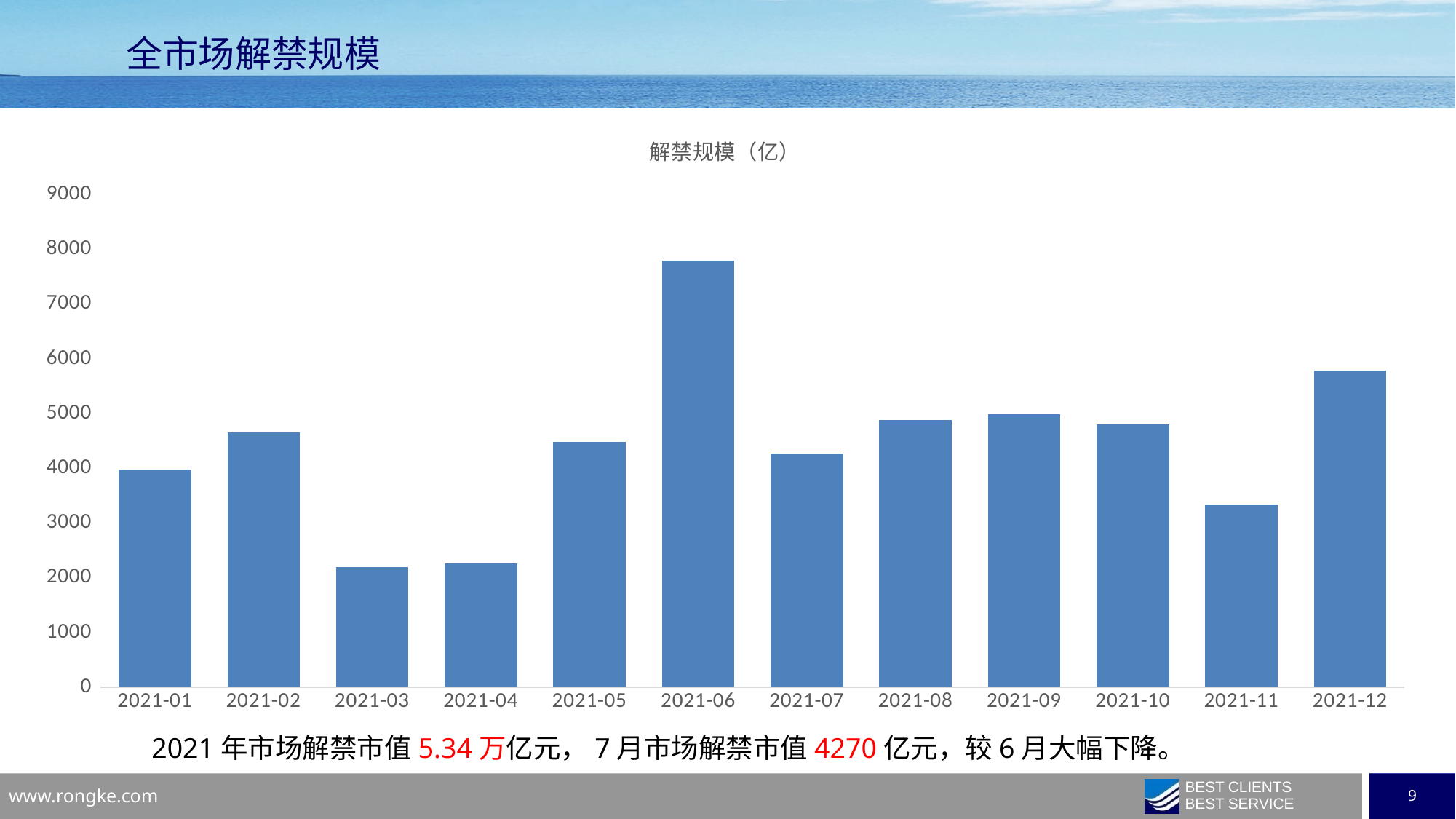
What is the title of the chart? 解禁规模（亿） What kind of chart is shown on the slide? bar chart Which is larger, the value for 2021-02 or the value for 2021-11? 2021-02 Which is larger, the value for 2021-06 or the value for 2021-12? 2021-06 Is the value for 2021-11 greater or less than 4000? less Which month has the highest 解禁规模? 2021-06 Is the value for 2021-12 greater or less than 5000? greater Is the value for 2021-06 greater or less than 7000? greater According to the text on the slide, what is the 解禁市值 for July (2021-07) in 亿元? 4270 How many months (categories) are plotted on the x axis? 12